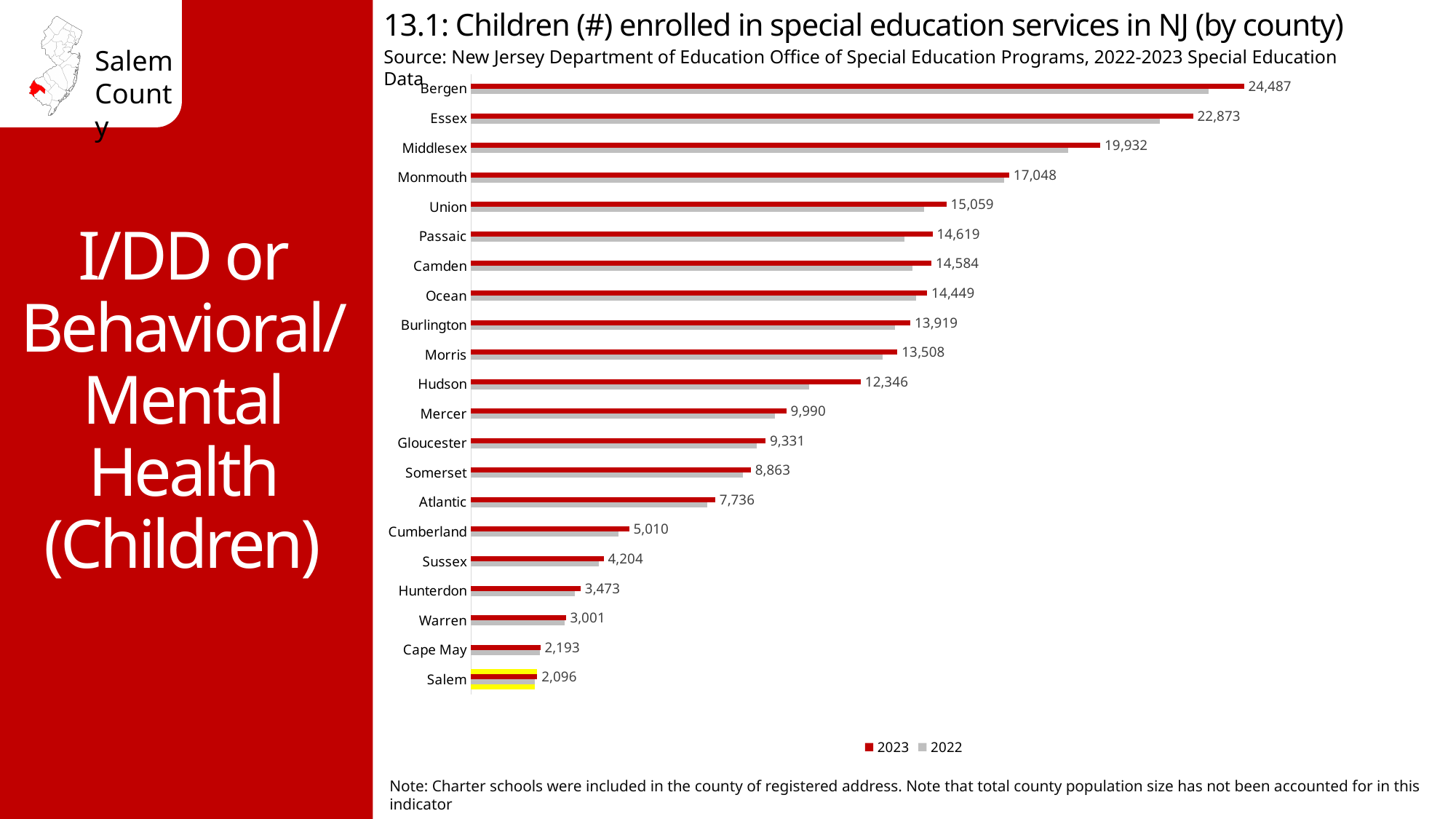
What is the difference between the 2023 values for Cape May and Salem counties? 97 Which county has the lowest number of children enrolled in special education services in 2023? Salem Which county has the highest number of children enrolled in special education services in 2023? Bergen How many children were enrolled in special education services in Bergen County in 2023? 24,487 What is the 2023 value for Salem County? 2,096 What is the 2023 value shown for Gloucester County? 9,331 How many series does the legend list? 2 How many counties are shown on the chart? 21 Which county has a larger 2023 value, Passaic or Camden? Passaic What is the difference between the 2023 values for Bergen and Salem counties? 22,391 What type of chart is shown on the slide? Bar chart For Hudson County, which year's bar is longer, 2023 or 2022? 2023